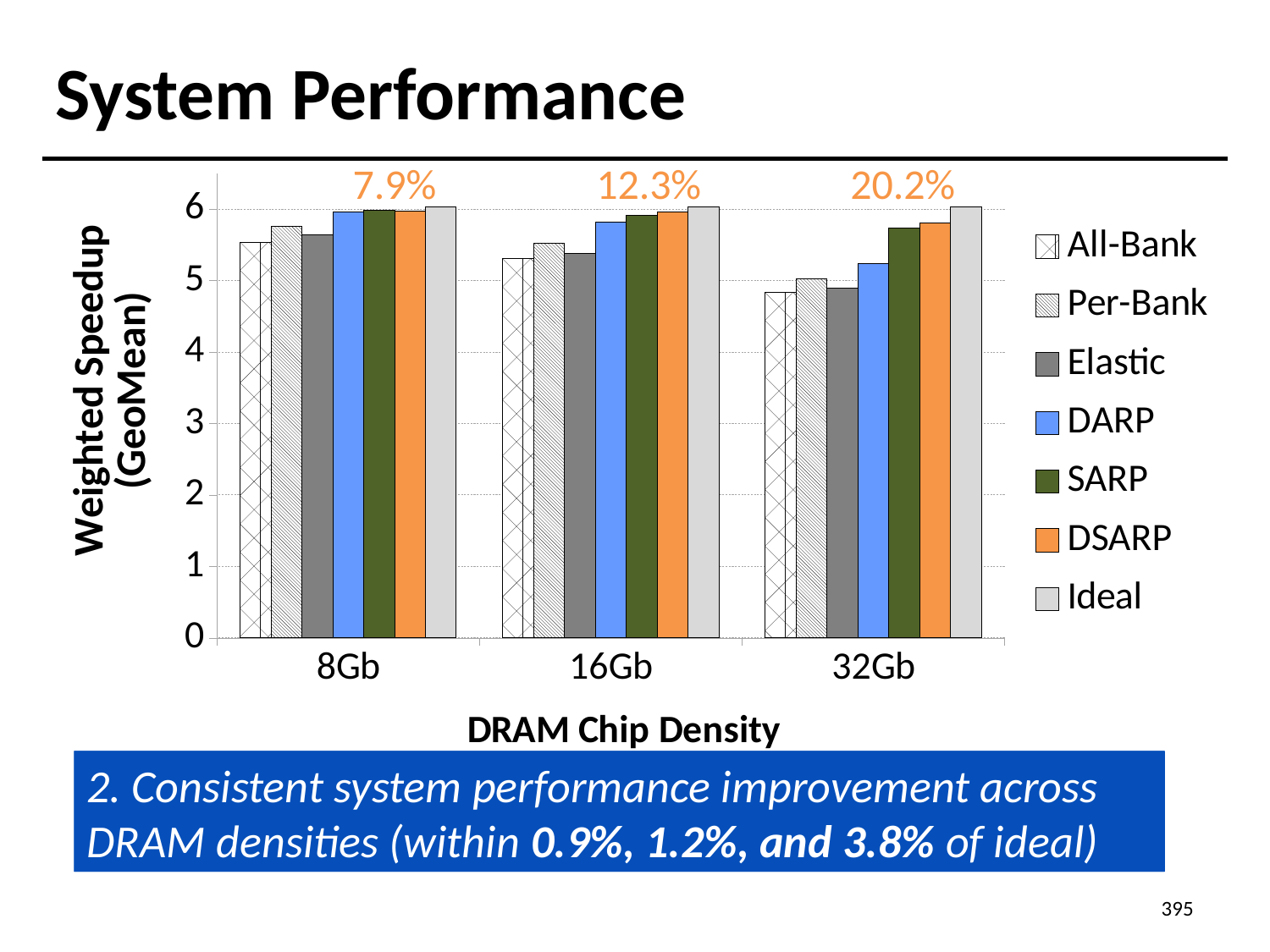
Is the value for DARP at 8Gb greater or less than 5? greater Is the value for All-Bank at 16Gb greater or less than 5? greater Which series has the highest value at 32Gb? Ideal At 16Gb, which is larger: DARP or Elastic? DARP At 32Gb, which is larger: Ideal or All-Bank? Ideal Is the value for All-Bank at 32Gb greater or less than 5? less What kind of chart is shown on the slide? bar chart What percentage is annotated above the 32Gb group of bars? 20.2% How many series does the legend list? 7 How many DRAM chip density categories are shown on the x axis? 3 Does the All-Bank value rise or fall as DRAM chip density increases from 8Gb to 32Gb? fall What is the title of the x axis? DRAM Chip Density